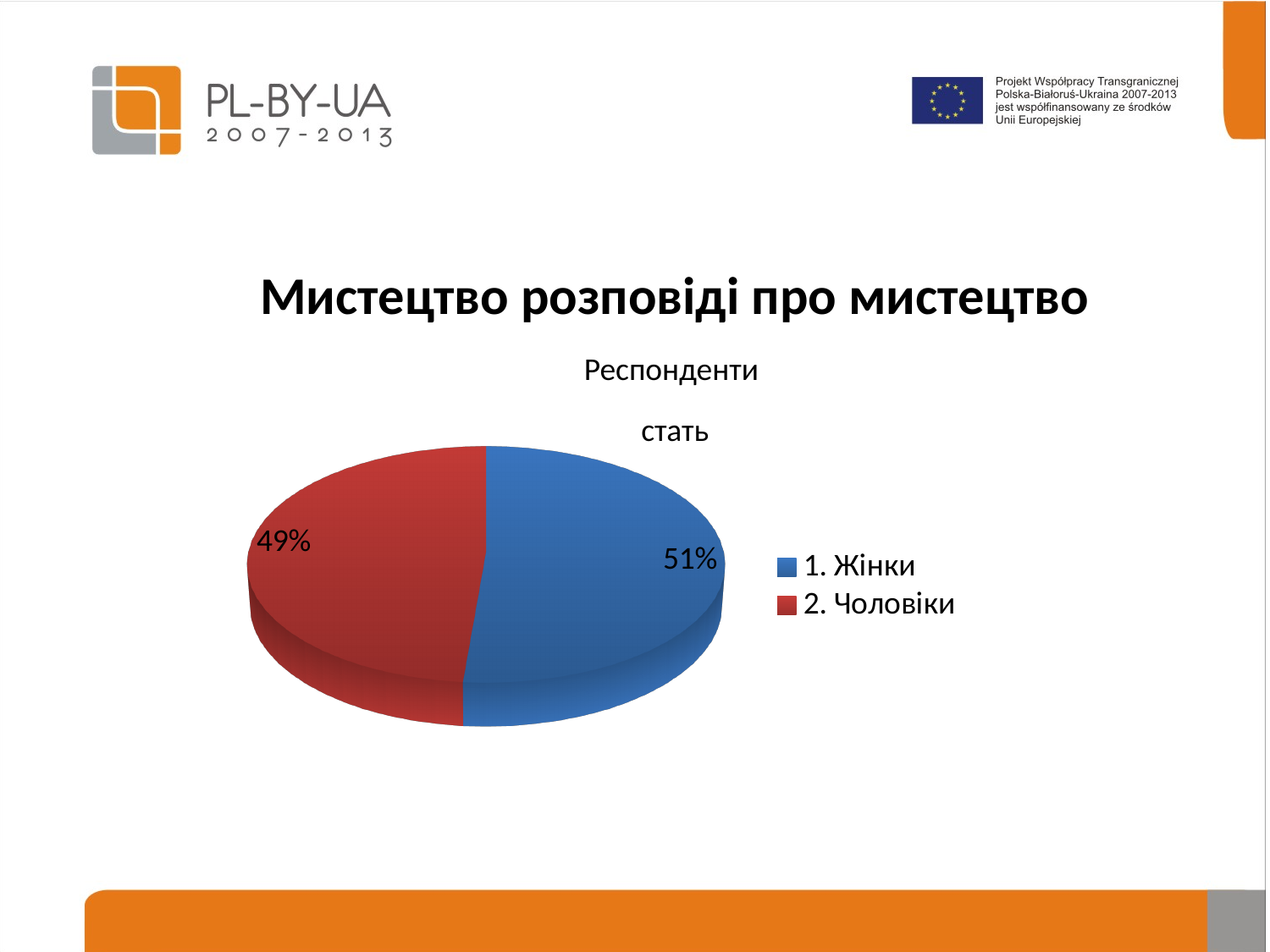
Is the share of 1. Жінки greater or less than 50%? greater What share of respondents are 1. Жінки? 51% Which category has the smallest share of the pie? 2. Чоловіки Which colour represents 2. Чоловіки in the pie chart? Red Which is larger, the share of 1. Жінки or the share of 2. Чоловіки? 1. Жінки What share of respondents are 2. Чоловіки? 49% What kind of chart is shown on the slide? Pie chart How many slices does the pie chart have? 2 How many entries does the legend list? 2 Which category has the largest share of the pie? 1. Жінки What is the difference in percentage points between the share of 1. Жінки and 2. Чоловіки? 2 percentage points